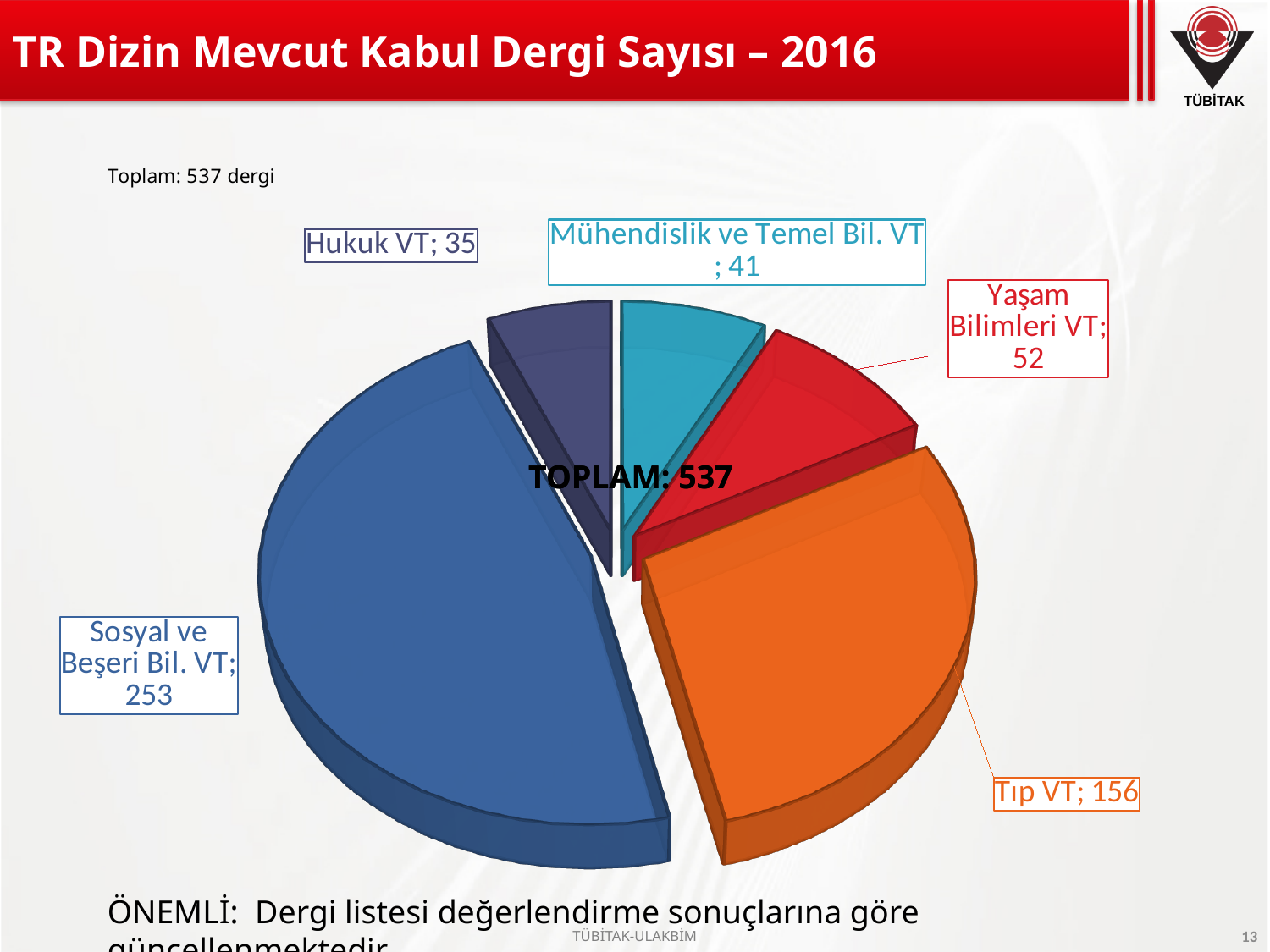
What is the value for Sosyal ve Beşeri Bil. VT? 253 What total is printed in the centre of the pie chart? TOPLAM: 537 Which is larger, Mühendislik ve Temel Bil. VT or Yaşam Bilimleri VT? Yaşam Bilimleri VT What is the difference between Sosyal ve Beşeri Bil. VT and Tıp VT? 97 What kind of chart is shown on the slide? pie chart How many slices does the pie chart have? 5 What is the title of the slide containing the chart? TR Dizin Mevcut Kabul Dergi Sayısı – 2016 What is the value for Yaşam Bilimleri VT? 52 What is the value for Hukuk VT? 35 Which category has the largest slice? Sosyal ve Beşeri Bil. VT Which category has the smallest slice? Hukuk VT What is the value for Tıp VT? 156